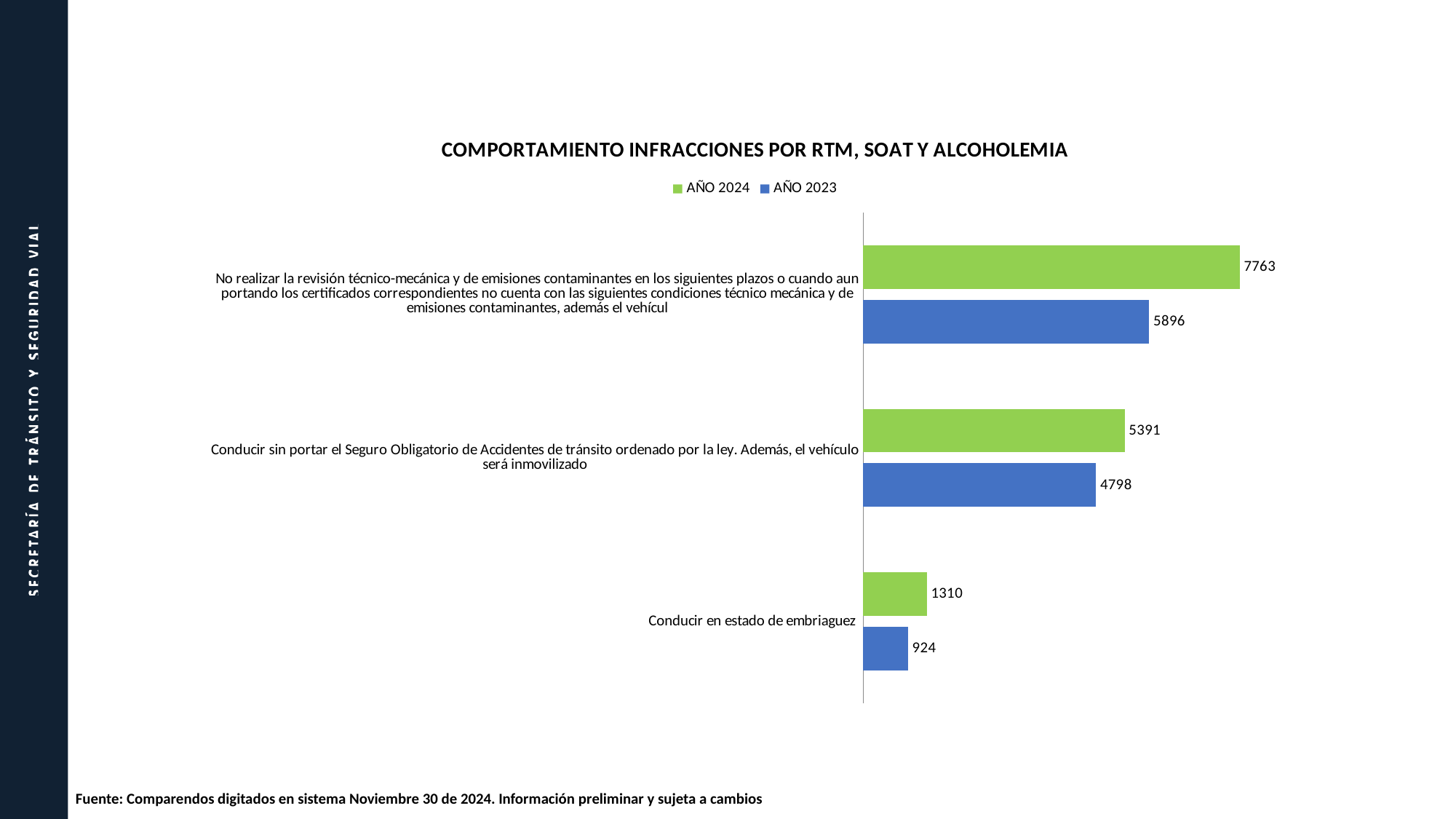
What type of chart is shown on the slide? Bar chart What is the AÑO 2024 value for 'Conducir en estado de embriaguez'? 1310 What is the AÑO 2024 value for 'Conducir sin portar el Seguro Obligatorio de Accidentes de tránsito...'? 5391 What is the AÑO 2023 value for the category about not performing the revisión técnico-mecánica? 5896 What is the AÑO 2023 value for 'Conducir en estado de embriaguez'? 924 How many categories are shown in the chart? 3 Which category has the highest AÑO 2024 value? No realizar la revisión técnico-mecánica y de emisiones contaminantes... For 'Conducir en estado de embriaguez', which year has the larger value, AÑO 2024 or AÑO 2023? AÑO 2024 How many series does the legend list? 2 What is the difference between the AÑO 2024 and AÑO 2023 values for the revisión técnico-mecánica category? 1867 What is the difference between the AÑO 2024 and AÑO 2023 values for 'Conducir sin portar el Seguro Obligatorio'? 593 Which category has the lowest AÑO 2023 value? Conducir en estado de embriaguez